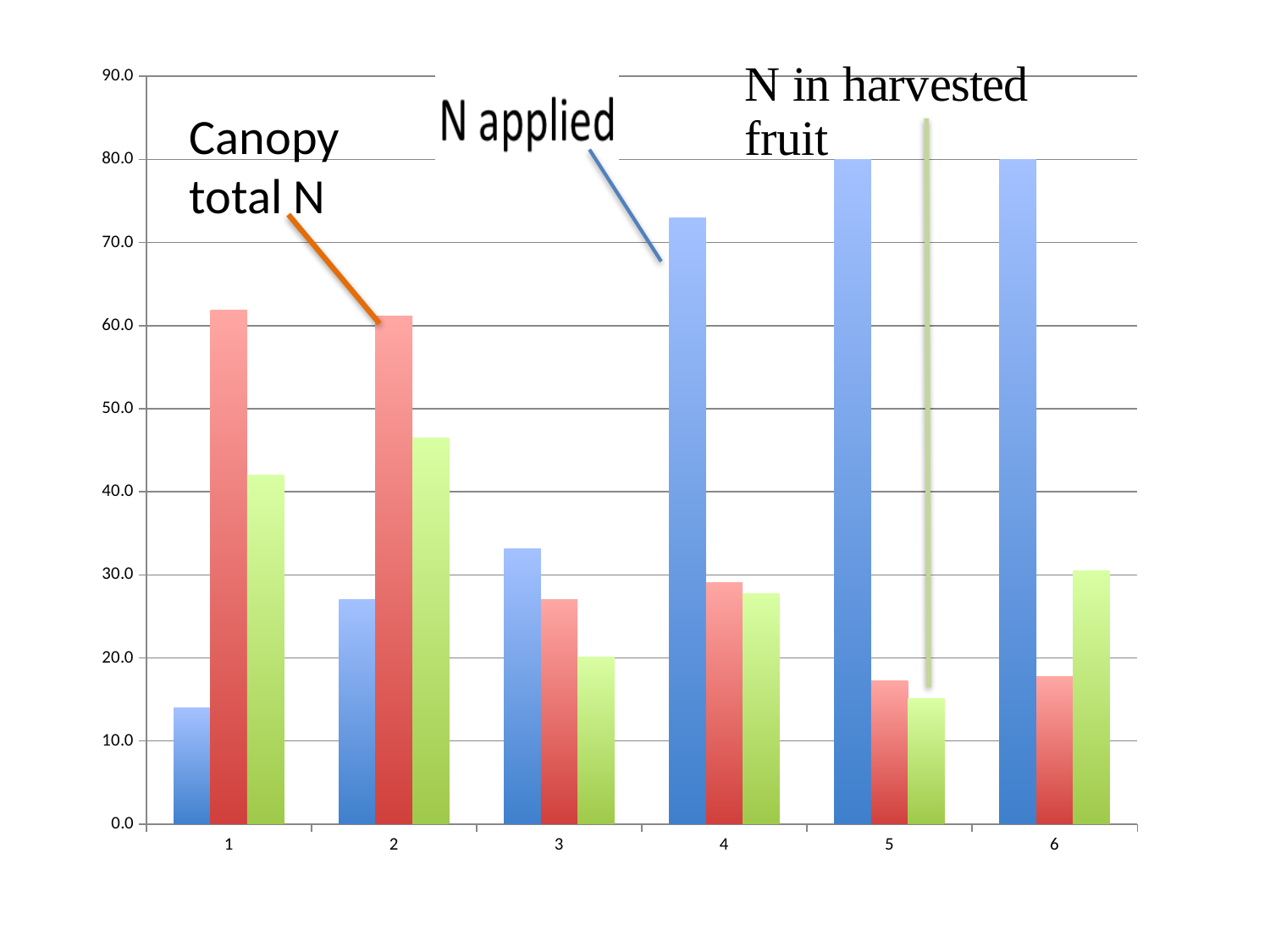
How many data series are plotted in the chart? 3 Which category has the highest N in harvested fruit value? 2 For category 4, which is larger: N applied or Canopy total N? N applied Is the N in harvested fruit value for category 2 greater or less than 40? greater What is the N applied value for category 5? 80.0 What is the N applied value for category 6? 80.0 Is the N applied value for category 1 greater or less than 20? less Which colour represents the N applied series? Blue How many categories are shown along the x axis? 6 Is the Canopy total N value for category 1 greater or less than 60? greater What kind of chart is shown on the slide? Bar chart Which category has the lowest N applied value? 1